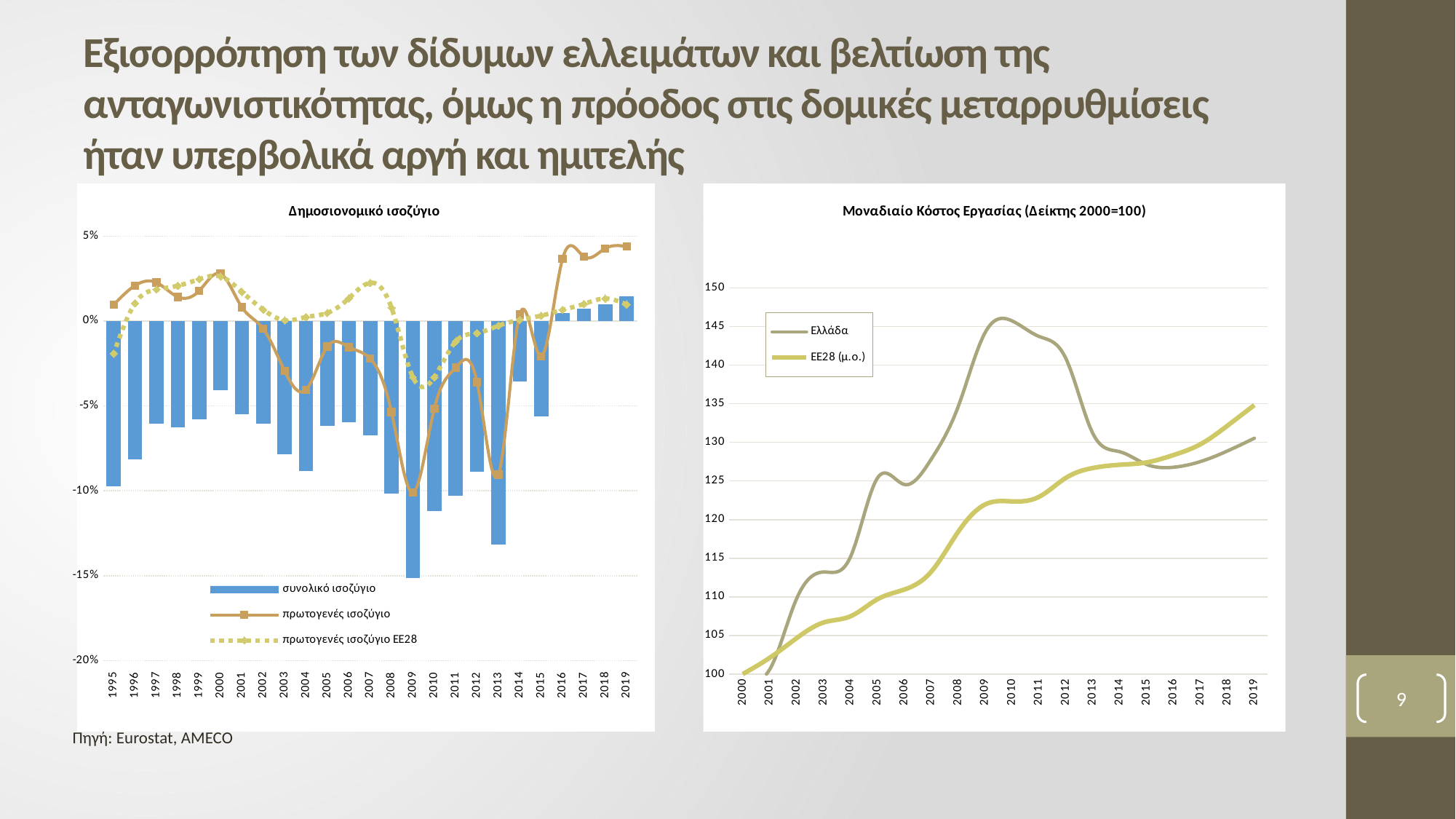
In the 'Δημοσιονομικό ισοζύγιο' chart, is the 'συνολικό ισοζύγιο' value for 2009 greater or less than -10%? less How many series does the legend of the 'Μοναδιαίο Κόστος Εργασίας' chart list? 2 How many series does the legend of the 'Δημοσιονομικό ισοζύγιο' chart list? 3 How many years are shown on the x axis of the 'Δημοσιονομικό ισοζύγιο' chart? 25 What kind of chart is the 'Δημοσιονομικό ισοζύγιο' chart on the left? Bar chart combined with line series In the 'Μοναδιαίο Κόστος Εργασίας' chart, does the 'ΕΕ28 (μ.ο.)' series rise or fall from 2000 to 2019? Rise What kind of chart is the 'Μοναδιαίο Κόστος Εργασίας (Δείκτης 2000=100)' chart on the right? Line chart How many years are shown on the x axis of the 'Μοναδιαίο Κόστος Εργασίας' chart? 20 In the 'Δημοσιονομικό ισοζύγιο' chart, which year has the lowest value for 'συνολικό ισοζύγιο'? 2009 In the 'Μοναδιαίο Κόστος Εργασίας' chart, is the value for 'ΕΕ28 (μ.ο.)' in 2019 greater or less than 130? greater In the 'Μοναδιαίο Κόστος Εργασίας' chart, which series has the higher value in 2019, 'Ελλάδα' or 'ΕΕ28 (μ.ο.)'? ΕΕ28 (μ.ο.) In the 'Μοναδιαίο Κόστος Εργασίας' chart, is the value for 'Ελλάδα' in 2010 greater or less than 140? greater